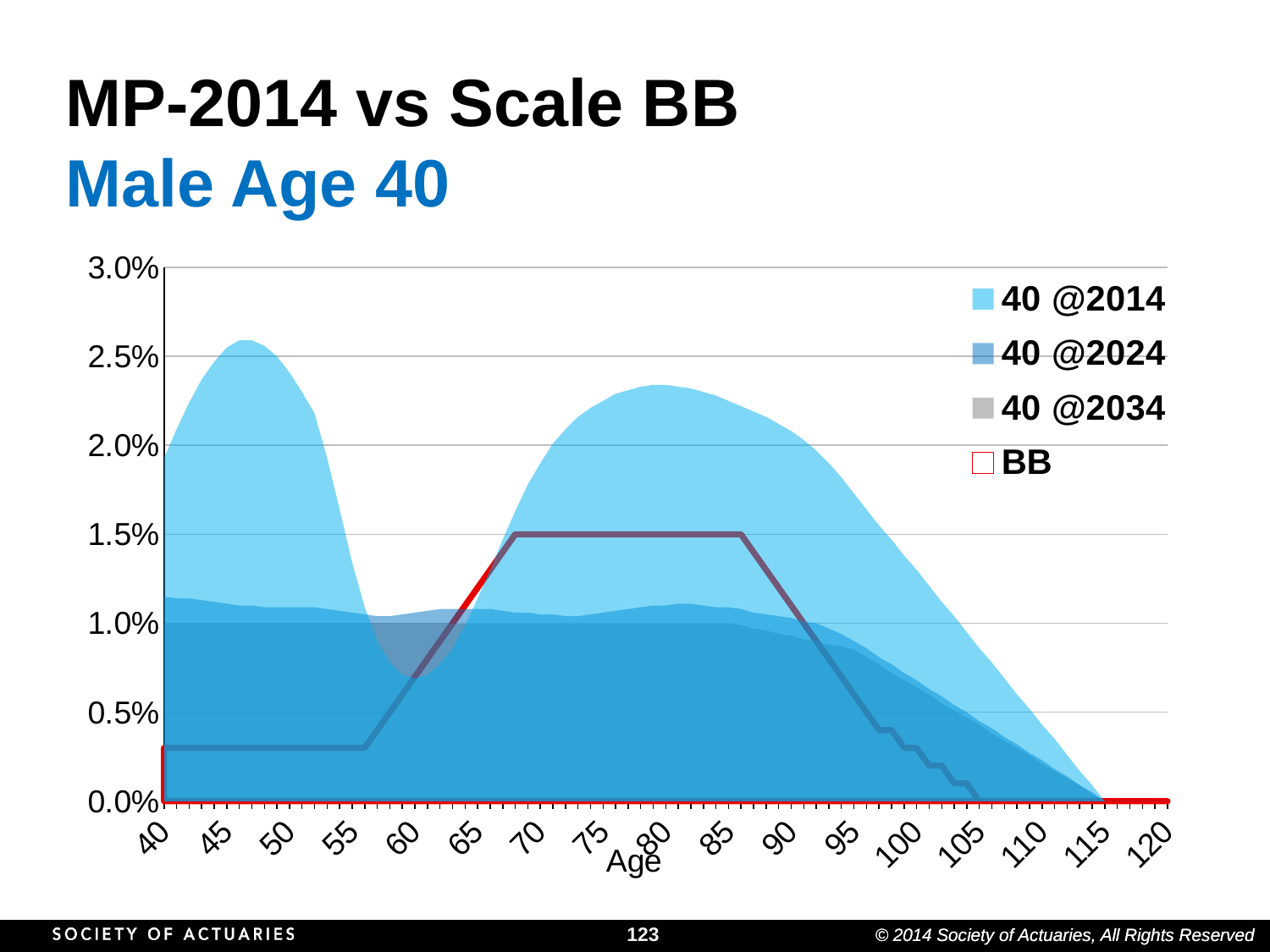
What kind of chart is shown on the slide? area chart Is the value of the BB line at age 80 greater or less than 1.0%? greater What is the label of the x axis? Age Is the value of the 40 @2014 series at age 47 greater or less than 2.0%? greater Does the BB line rise or fall between age 90 and age 105? fall Is the value of the BB line at age 50 greater or less than 0.5%? less How many series does the legend list? 4 At age 47, which series has the larger value, 40 @2014 or 40 @2024? 40 @2014 What are the legend entries of the chart? 40 @2014, 40 @2024, 40 @2034, BB